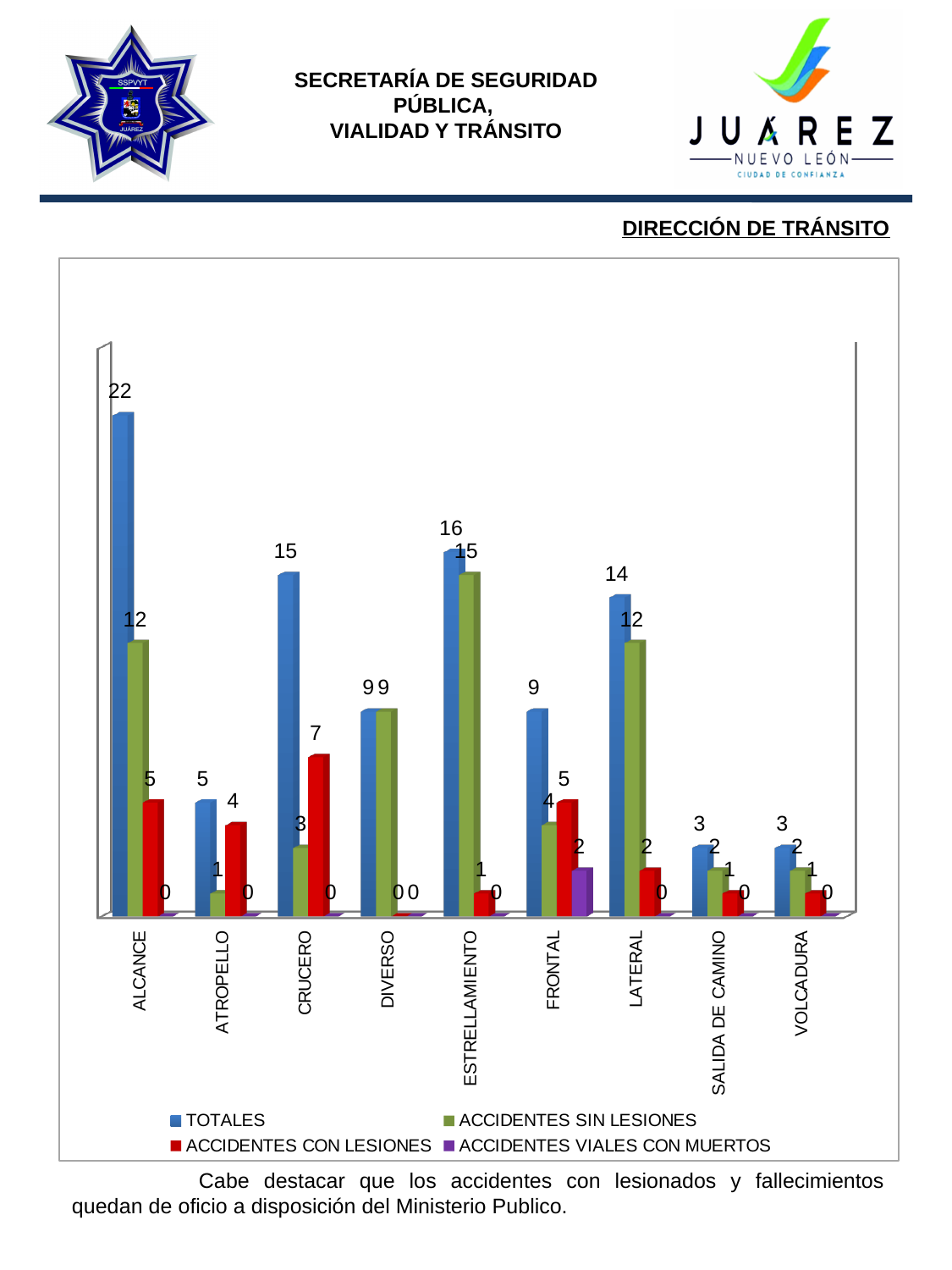
Which category has the highest TOTALES value? ALCANCE How many categories are shown on the x axis? 9 Which category has the lowest ACCIDENTES SIN LESIONES value? ATROPELLO What is the difference between the TOTALES values for ALCANCE and LATERAL? 8 What is the ACCIDENTES CON LESIONES value for CRUCERO? 7 What is the ACCIDENTES SIN LESIONES value for ESTRELLAMIENTO? 15 How many series does the legend list? 4 What is the TOTALES value for ALCANCE? 22 Which is larger, the ACCIDENTES CON LESIONES value for ATROPELLO or for LATERAL? ATROPELLO What is the ACCIDENTES VIALES CON MUERTOS value for FRONTAL? 2 Which colour represents the ACCIDENTES VIALES CON MUERTOS series? Purple What kind of chart is shown on the slide? Bar chart